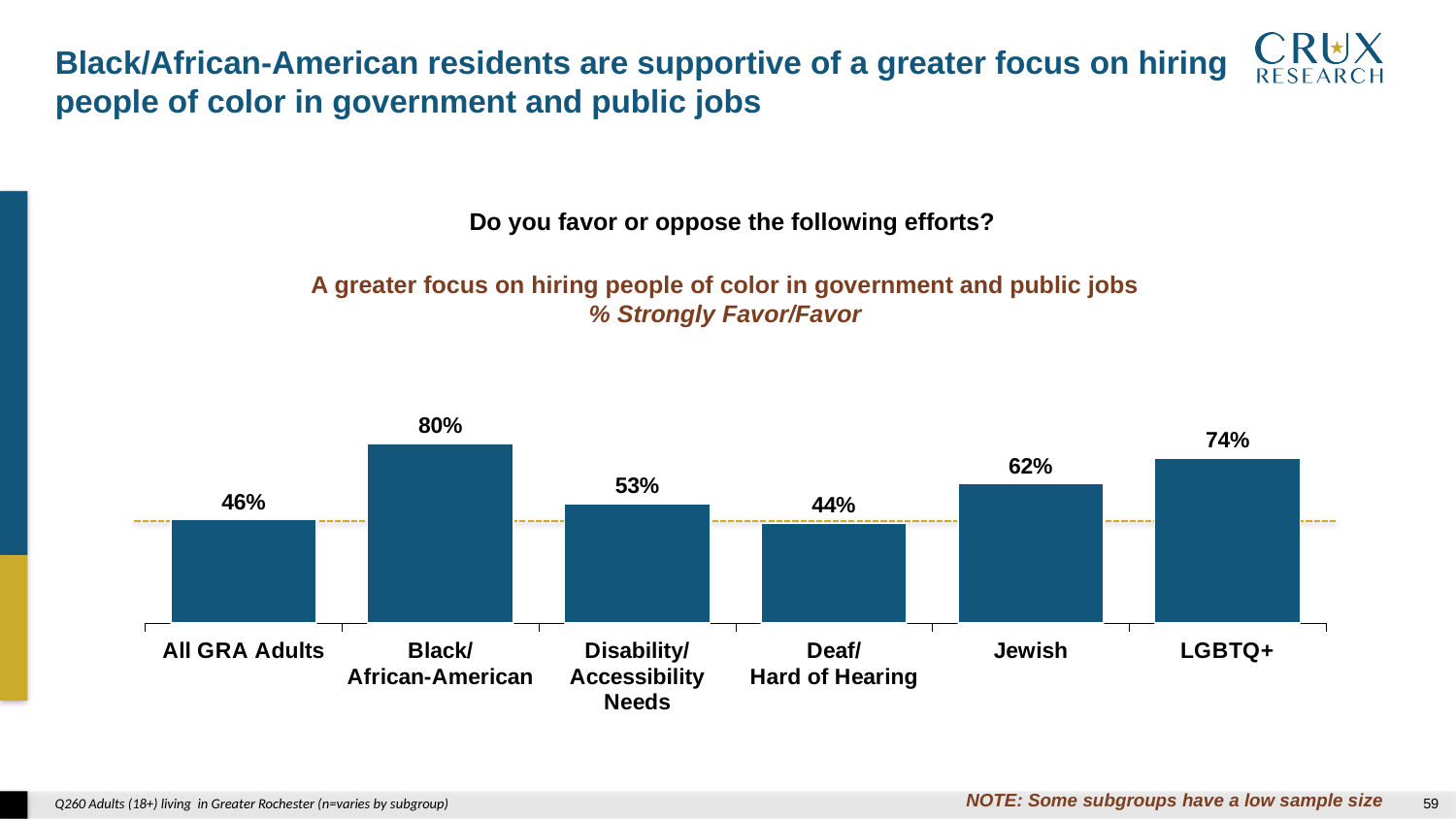
Which group has a higher value, Jewish or LGBTQ+? LGBTQ+ What is the value shown for the Deaf/Hard of Hearing group? 44% Which group has the lowest percentage of Strongly Favor/Favor? Deaf/Hard of Hearing What kind of chart is shown on the slide? Bar chart What percentage of Black/African-American respondents strongly favor or favor a greater focus on hiring people of color in government and public jobs? 80% What is the difference in percentage points between the Black/African-American group and All GRA Adults? 34 What is the value shown for All GRA Adults? 46% What is the value shown for the LGBTQ+ group? 74% Which group has the highest percentage of Strongly Favor/Favor? Black/African-American What measure does the chart subtitle say the bars represent? % Strongly Favor/Favor How many groups are shown in the chart? 6 What is the difference in percentage points between the Jewish group and the Disability/Accessibility Needs group? 9